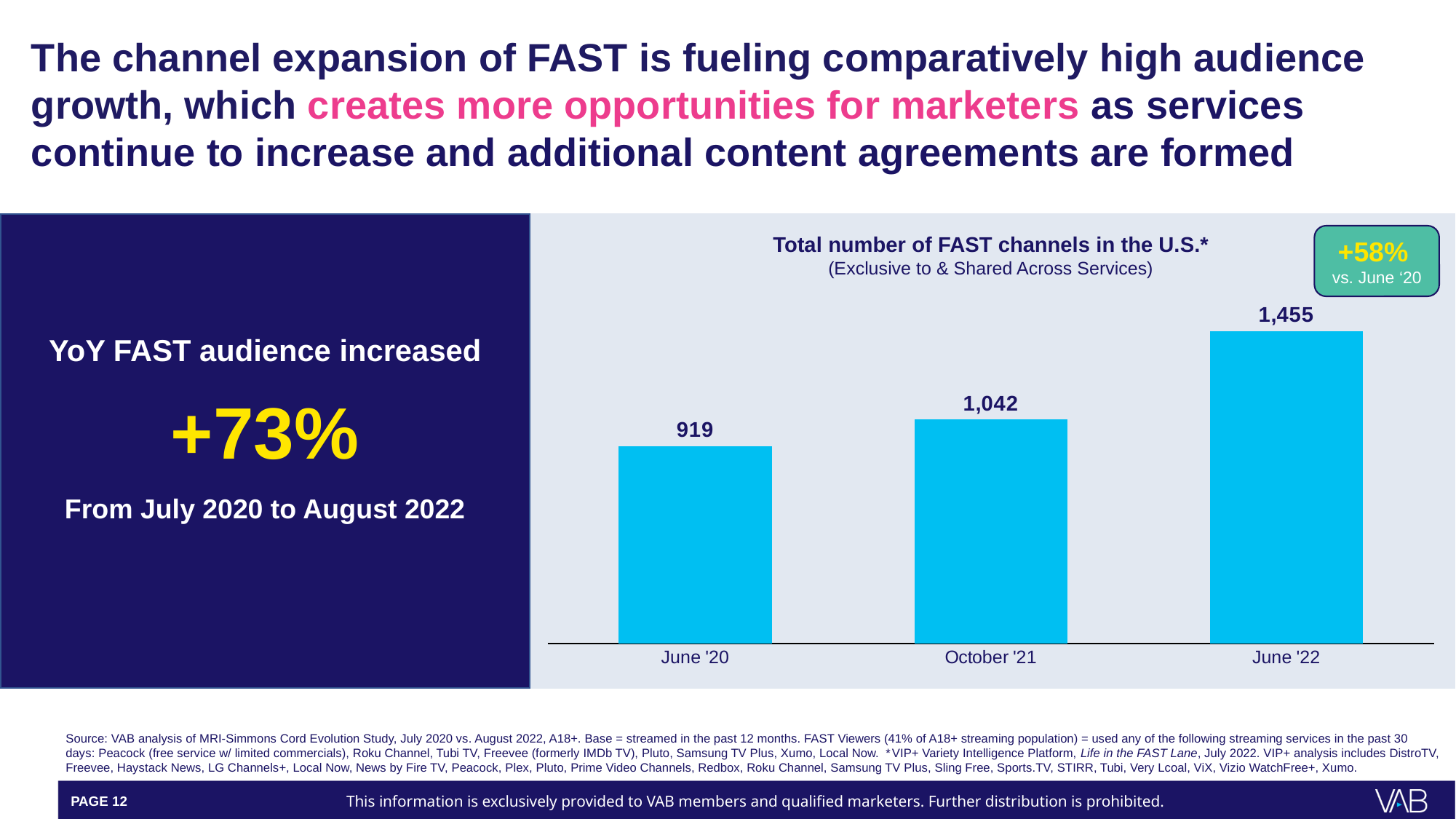
What is the total number of FAST channels in the U.S. for October '21? 1,042 What is the total number of FAST channels in the U.S. for June '22? 1,455 How many time periods are shown in the chart? 3 What is the total number of FAST channels in the U.S. for June '20? 919 Do the number of FAST channels rise or fall from June '20 to June '22? Rise What is the difference in the number of FAST channels between June '22 and June '20? 536 Which period has the highest number of FAST channels? June '22 What percentage change vs. June '20 is shown in the callout on the chart? +58% Which period has the lowest number of FAST channels? June '20 What type of chart is used to show the total number of FAST channels? Bar chart Which has more FAST channels, October '21 or June '22? June '22 What is the difference in the number of FAST channels between October '21 and June '20? 123